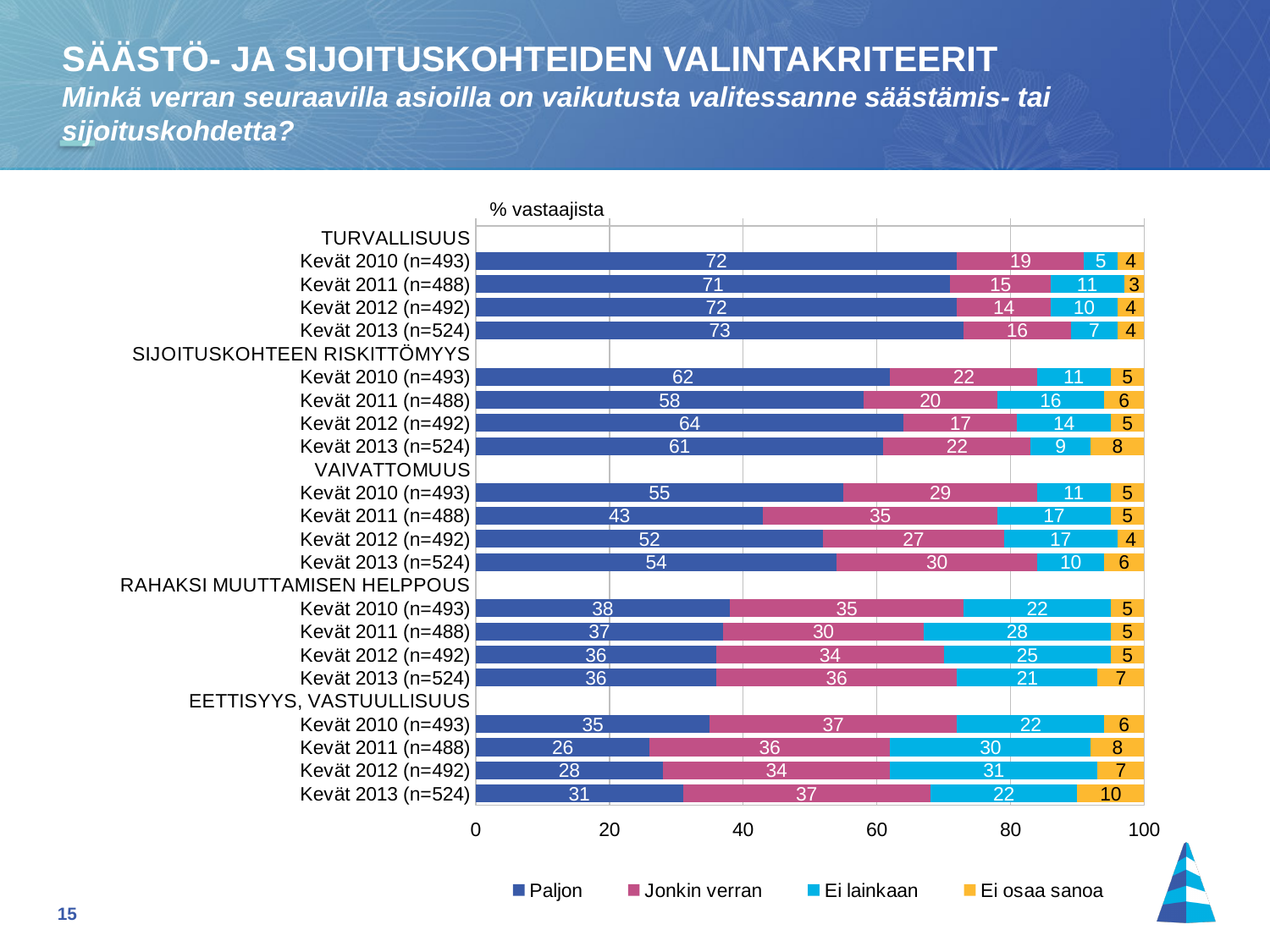
What is the 'Ei lainkaan' value for EETTISYYS, VASTUULLISUUS in Kevät 2012 (n=492)? 31 What is the difference between the 'Paljon' values for SIJOITUSKOHTEEN RISKITTÖMYYS in Kevät 2012 (n=492) and Kevät 2011 (n=488)? 6 What is the total of the stacked bar for EETTISYYS, VASTUULLISUUS in Kevät 2011 (n=488)? 100 How many series does the legend list? 4 Which is larger: the 'Ei lainkaan' value for RAHAKSI MUUTTAMISEN HELPPOUS in Kevät 2011 (n=488) or in Kevät 2013 (n=524)? Kevät 2011 (n=488) Within the TURVALLISUUS group, which year has the highest 'Paljon' value? Kevät 2013 (n=524) What kind of chart is shown on the slide? Stacked bar chart Within the VAIVATTOMUUS group, which year has the lowest 'Paljon' value? Kevät 2011 (n=488) What is the 'Paljon' value for TURVALLISUUS in Kevät 2013 (n=524)? 73 What is the 'Jonkin verran' value for VAIVATTOMUUS in Kevät 2011 (n=488)? 35 What is the 'Ei osaa sanoa' value for EETTISYYS, VASTUULLISUUS in Kevät 2013 (n=524)? 10 What is the label of the first series in the legend? Paljon